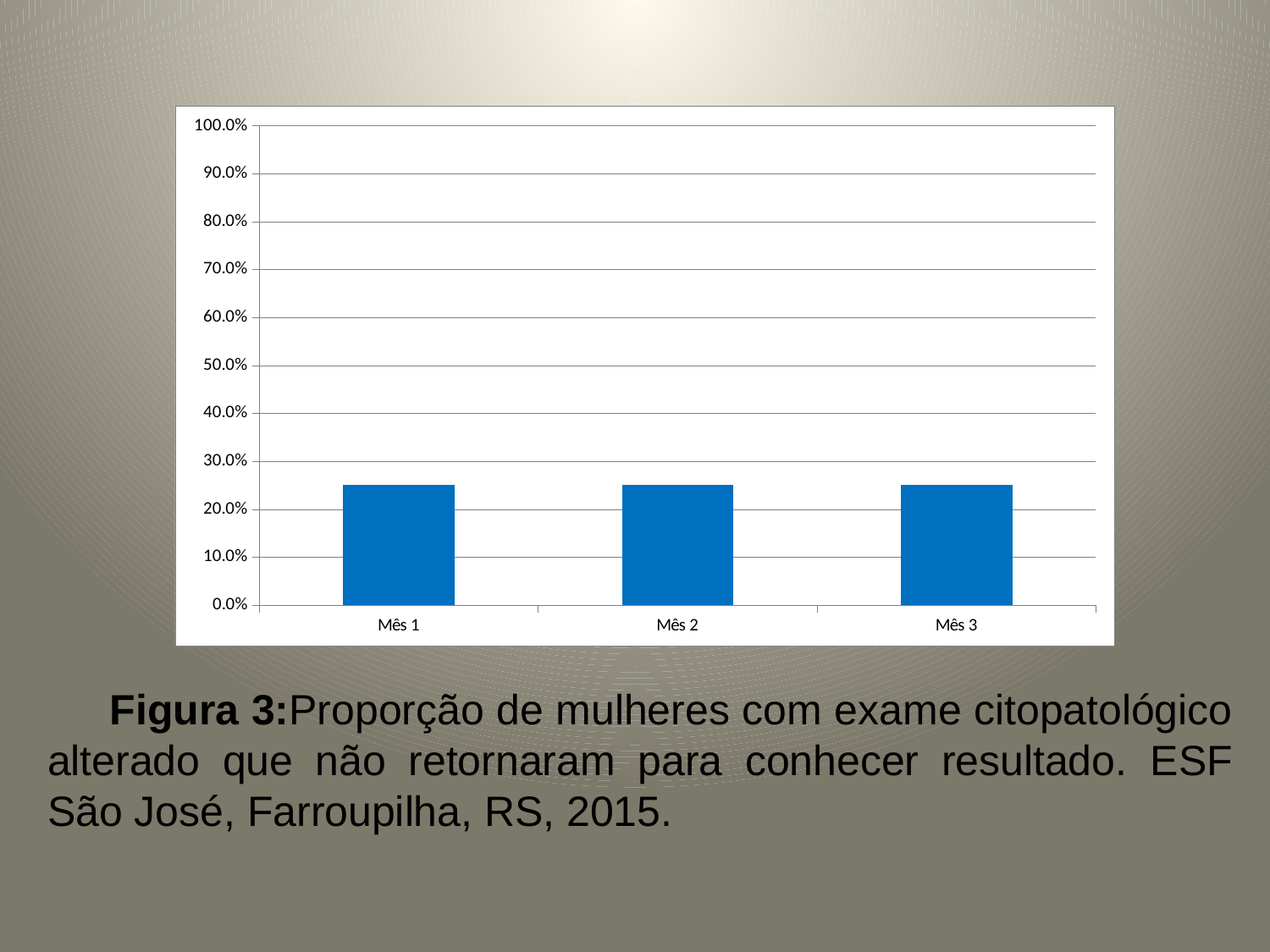
How many categories are shown on the x axis of the chart? 3 Is the value for Mês 2 greater or less than 10.0%? greater Is the value for Mês 2 greater or less than 30.0%? less Is the value for Mês 3 greater or less than 50.0%? less Do the values rise, fall, or stay the same from Mês 1 to Mês 3? stay the same What kind of chart is shown on the slide? bar chart What is the label of the first category on the x axis? Mês 1 What is the highest value shown on the y axis of the chart? 100.0%